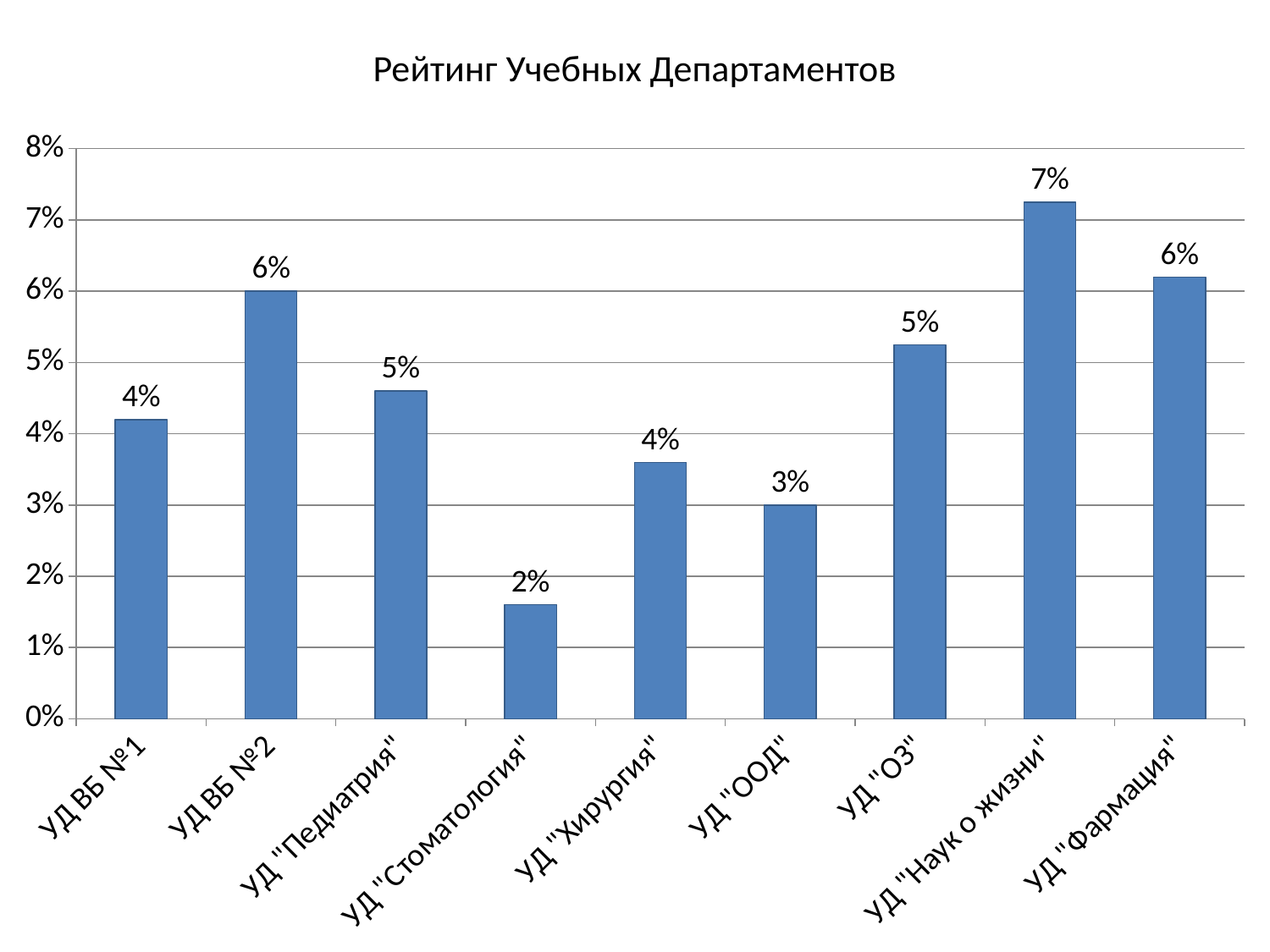
What is the difference between the labelled values for УД "Наук о жизни" and УД "Стоматология"? 5% What is the value shown for УД ВБ №2? 6% Which has a larger value, УД ВБ №2 or УД "Хирургия"? УД ВБ №2 Is the value for УД "Педиатрия" greater or less than 4%? greater What is the title of the chart? Рейтинг Учебных Департаментов What kind of chart is shown on the slide? bar chart What is the value shown for УД "ООД"? 3% Which department has the highest value? УД "Наук о жизни" What is the value shown for УД "Стоматология"? 2% How many departments are shown on the chart? 9 Which department has the lowest value? УД "Стоматология"